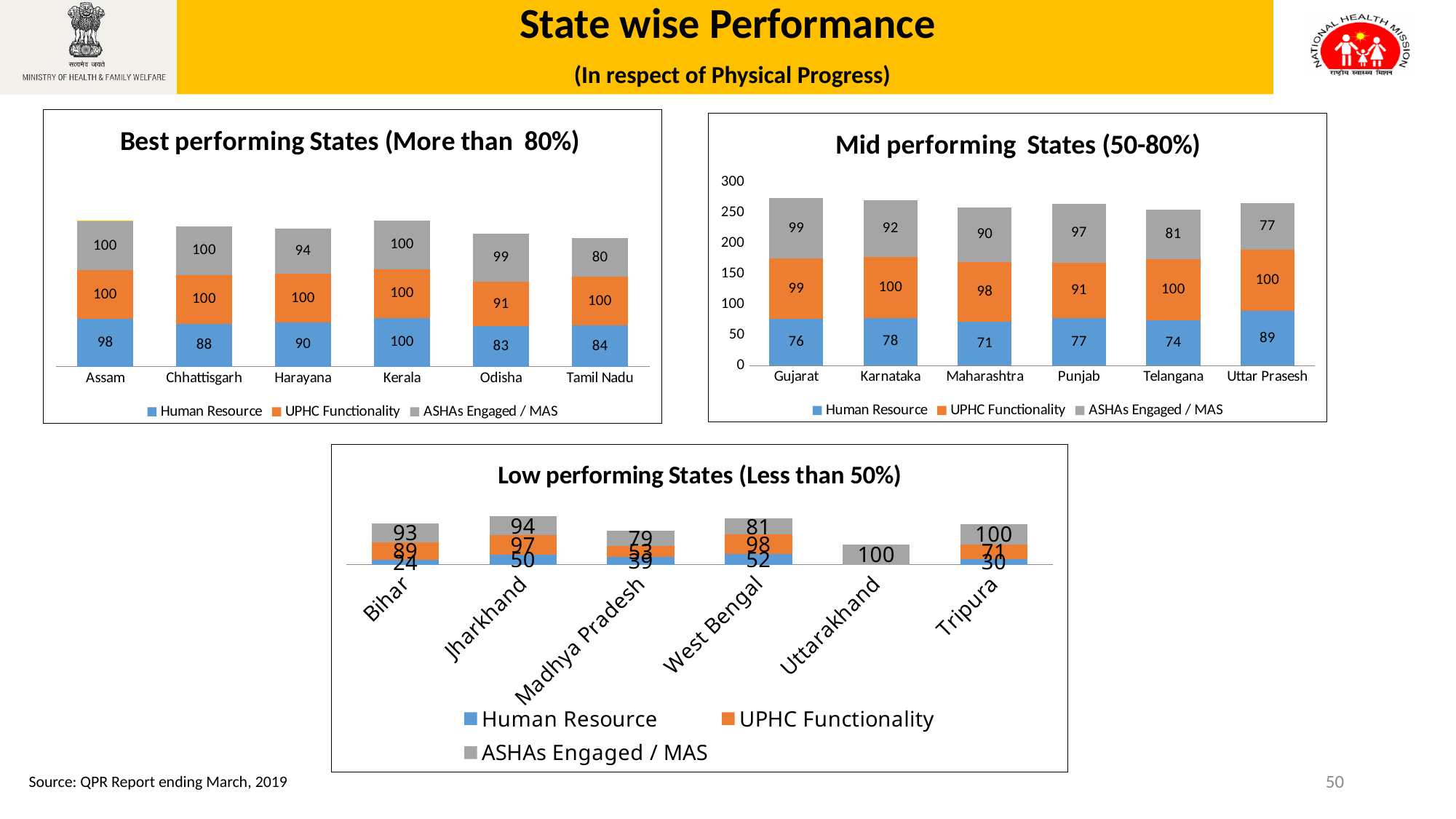
In the Mid performing States chart, how many states are shown? 6 In the Low performing States chart, what is the ASHAs Engaged / MAS value for Uttarakhand? 100 In the Best performing States chart, which state has the lowest Human Resource value? Odisha How many series does the legend of the Best performing States chart list? 3 In the Best performing States chart, what is the Human Resource value for Assam? 98 In the Best performing States chart, what is the ASHAs Engaged / MAS value for Tamil Nadu? 80 In the Best performing States chart, what is the total of the stacked bar for Kerala? 300 In the Mid performing States chart, which state has the lowest Human Resource value? Maharashtra In the Mid performing States chart, what is the difference between the ASHAs Engaged / MAS values for Gujarat and Telangana? 18 In the Low performing States chart, which is larger, the Human Resource value for Jharkhand or for Bihar? Jharkhand In the Mid performing States chart, what is the Human Resource value for Uttar Prasesh? 89 In the Mid performing States chart, is the total stacked bar for Punjab greater or less than 250? greater